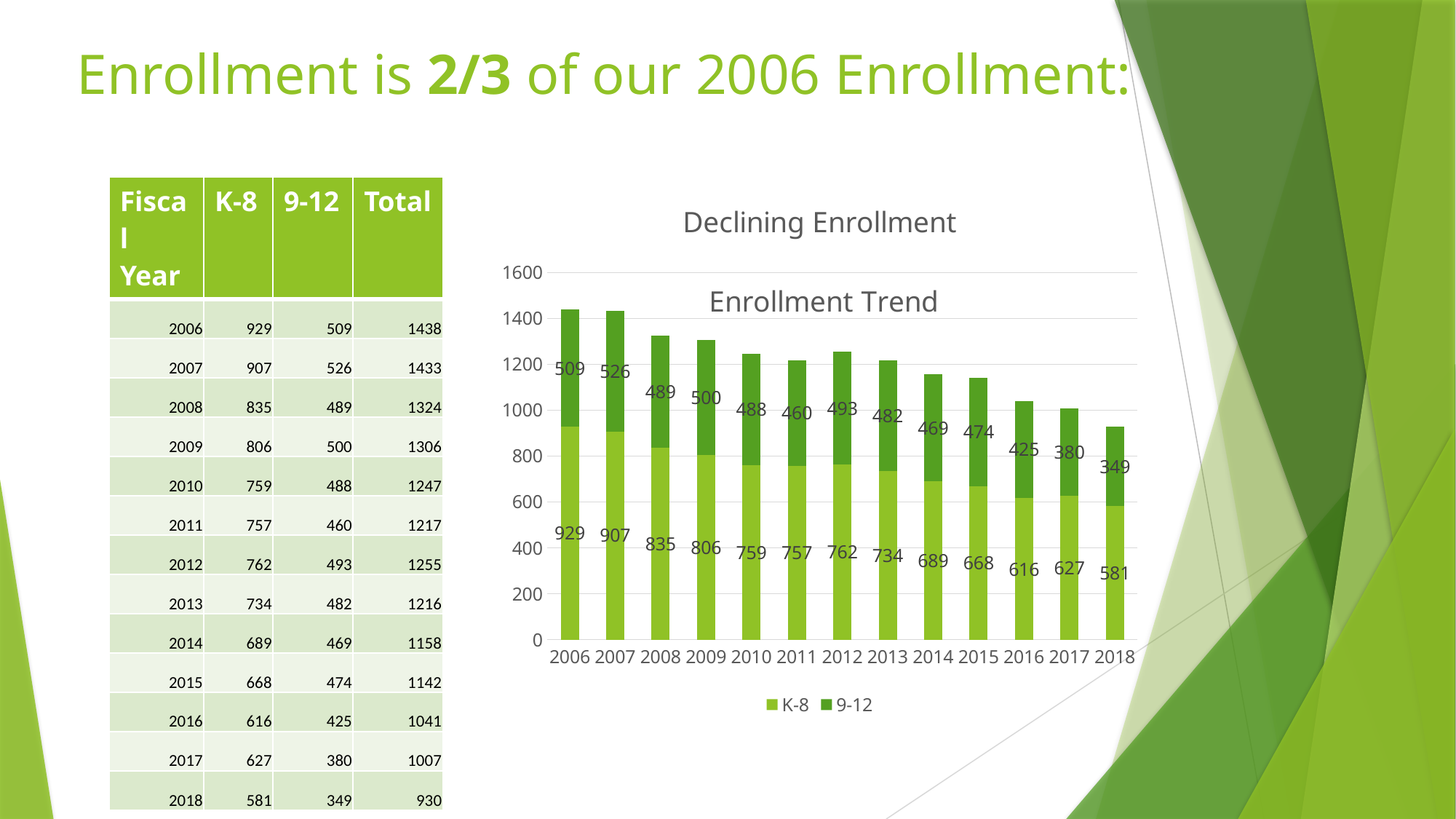
What is the difference between the K-8 values for 2006 and 2018 in the Declining Enrollment chart? 348 What is the K-8 value for 2006 in the Declining Enrollment chart? 929 What is the 9-12 value for 2018 in the Declining Enrollment chart? 349 Which is larger in the Declining Enrollment chart: the 9-12 value for 2007 or the 9-12 value for 2017? 2007 What is the total of the stacked bar for 2018 in the Declining Enrollment chart? 930 What is the 9-12 value for 2012 in the Declining Enrollment chart? 493 Which year has the lowest 9-12 value in the Declining Enrollment chart? 2018 What kind of chart is the Declining Enrollment chart? Stacked bar chart Which year has the highest K-8 value in the Declining Enrollment chart? 2006 How many years are shown on the x axis of the Declining Enrollment chart? 13 What is the total of the stacked bar for 2006 in the Declining Enrollment chart? 1438 How many series does the legend of the Declining Enrollment chart list? 2